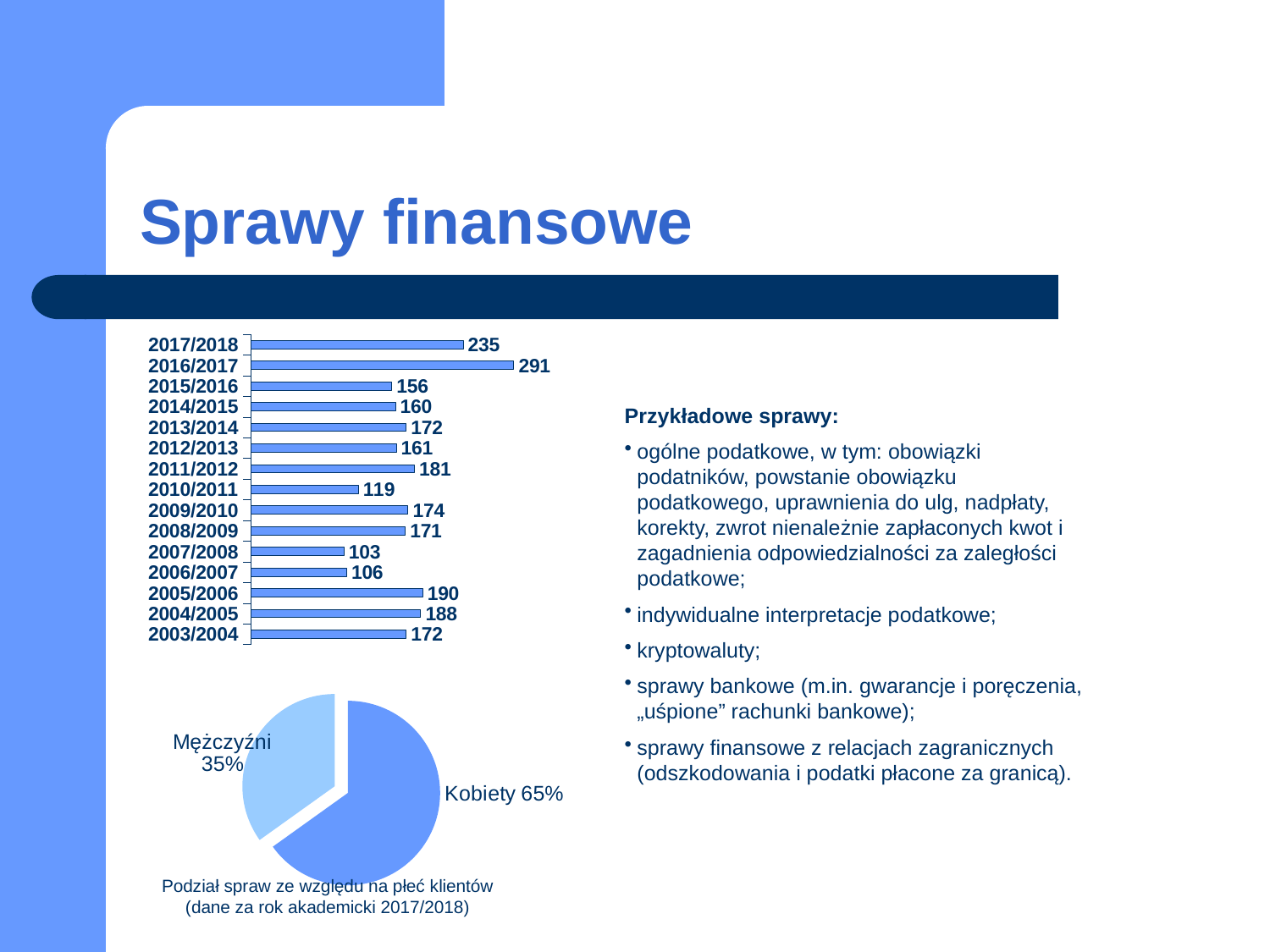
What is the caption below the pie chart at the bottom left? Podział spraw ze względu na płeć klientów (dane za rok akademicki 2017/2018) In the bar chart at the top left, which is larger, the value for 2005/2006 or the value for 2004/2005? 2005/2006 In the pie chart at the bottom left, what share is labelled Kobiety? 65% In the pie chart at the bottom left, what share is labelled Mężczyźni? 35% In the bar chart at the top left, how many academic years are shown? 15 In the bar chart at the top left, what is the value for 2010/2011? 119 In the bar chart at the top left, what is the value for 2016/2017? 291 In the bar chart at the top left, what is the value for 2003/2004? 172 In the bar chart at the top left, which academic year has the highest value? 2016/2017 In the bar chart at the top left, which academic year has the lowest value? 2007/2008 In the bar chart at the top left, what is the difference between the values for 2016/2017 and 2017/2018? 56 What kind of chart is the chart at the top left of the slide? Bar chart